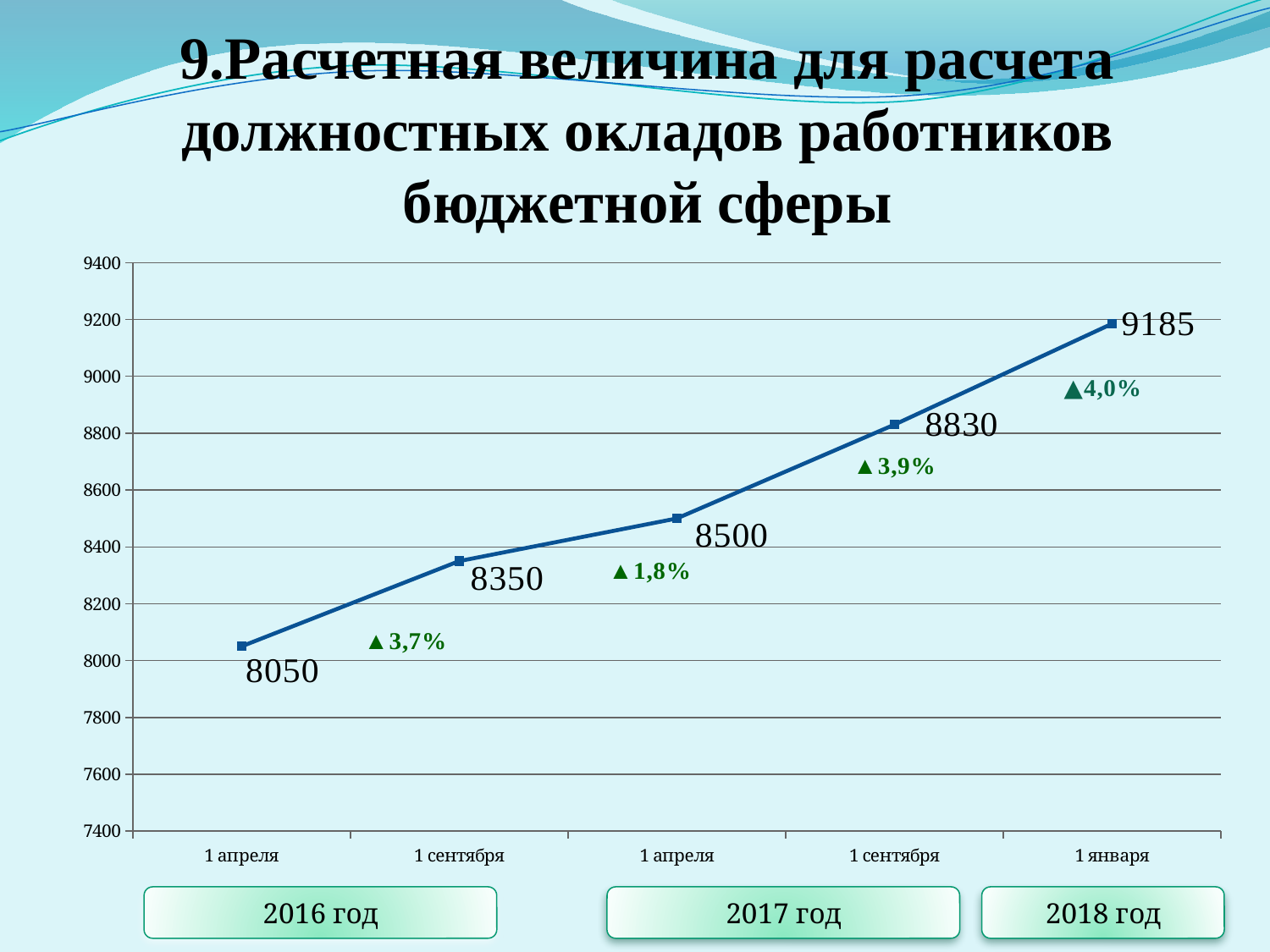
How many data points are plotted on the chart? 5 What is the difference between the values for 1 января 2018 год and 1 апреля 2016 год? 1135 What is the value for 1 января 2018 год? 9185 Do the values rise or fall from left to right along the x axis? rise What is the value for 1 апреля 2016 год? 8050 What percentage increase is labelled between 1 апреля 2017 год and 1 сентября 2017 год? 3,9% Which is larger, the value for 1 сентября 2016 год or the value for 1 апреля 2017 год? 1 апреля 2017 год What is the difference between the values for 1 сентября 2016 год and 1 апреля 2017 год? 150 What is the value for 1 сентября 2017 год? 8830 Which point has the highest value? 1 января 2018 год Which point has the lowest value? 1 апреля 2016 год What kind of chart is shown on the slide? line chart